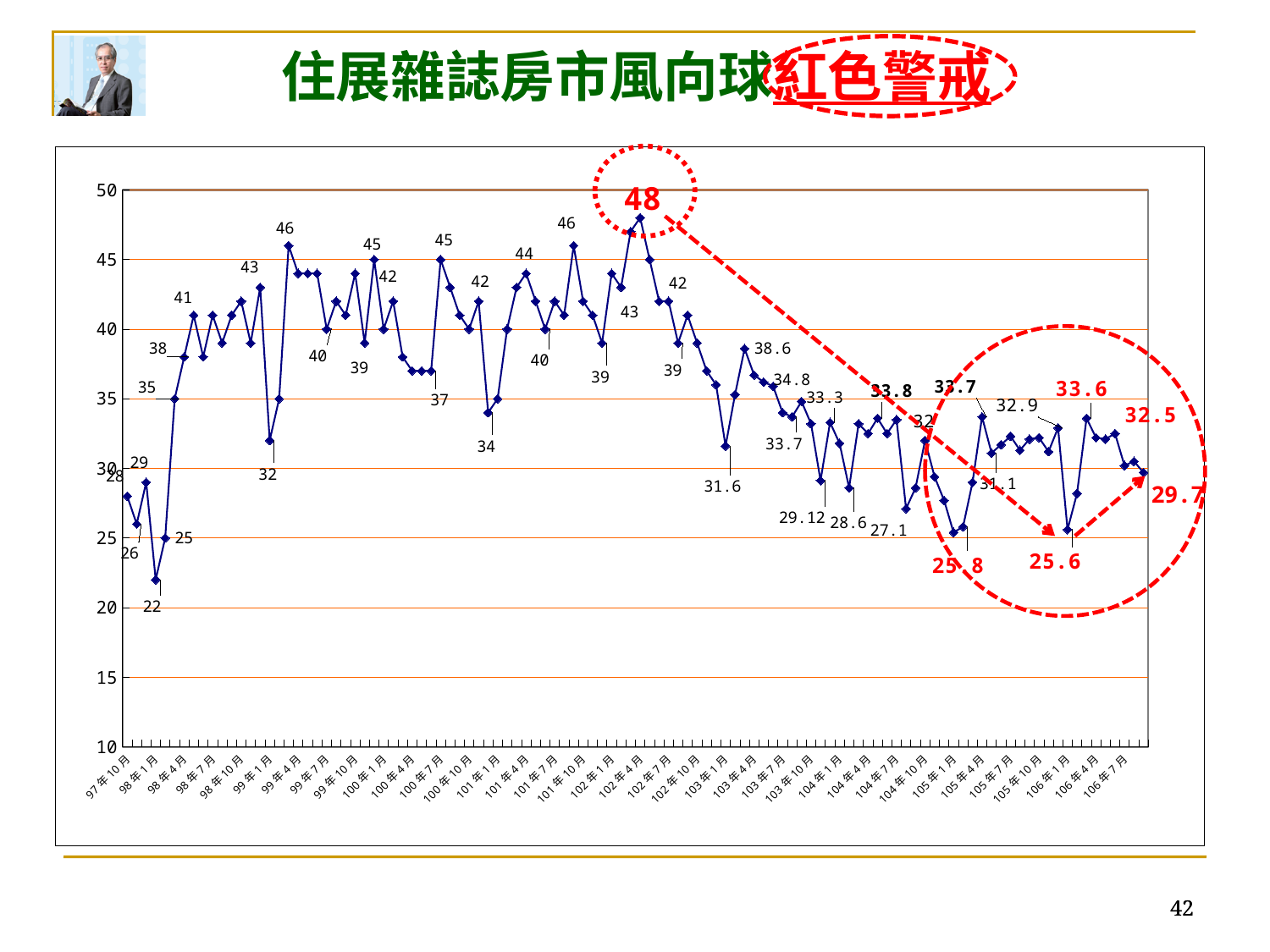
Which is larger, the peak labelled 48 or the earlier peak labelled 46? 48 What is the highest value labelled on the line chart? 48 What is the value labelled at the first point, 97年10月? 28 What is the difference between the highest labelled value (48) and the lowest labelled value (22)? 26 What is the lowest value labelled on the line chart? 22 What is the last labelled value at the right end of the line? 29.7 What is the difference between the labelled values 33.6 and 25.6 in the circled region at the right? 8 How many lines are plotted on the chart? 1 From the peak of 48 to the right end of the chart, do the values generally rise or fall? fall Which value is highlighted with a dotted red circle at the top of the chart? 48 Is the peak value of the line greater or less than 50? less What kind of chart is shown on the slide? line chart